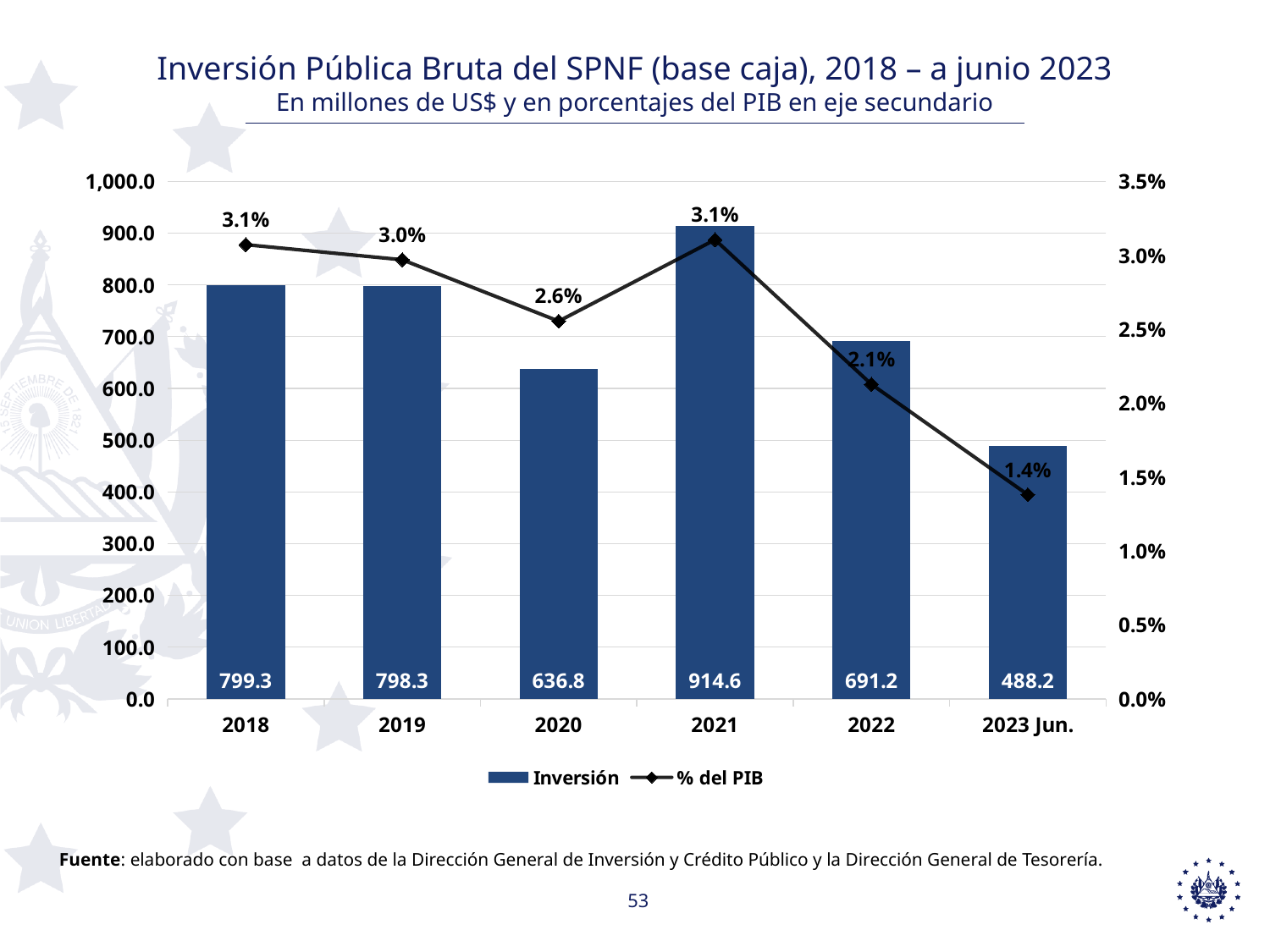
How many series does the legend list? 2 Is the Inversión value for 2019 greater or less than 700.0? greater Which year has the highest Inversión value? 2021 What is the Inversión value for 2021? 914.6 What kind of chart is used to show the Inversión series? bar chart How many categories are shown on the x axis? 6 What is the % del PIB value for 2020? 2.6% What is the Inversión value for 2023 Jun.? 488.2 Does the % del PIB series rise or fall from 2021 to 2023 Jun.? fall Which category has the lowest % del PIB value? 2023 Jun. Which is larger, the Inversión value for 2020 or for 2022? 2022 What is the difference between the Inversión values for 2021 and 2022? 223.4